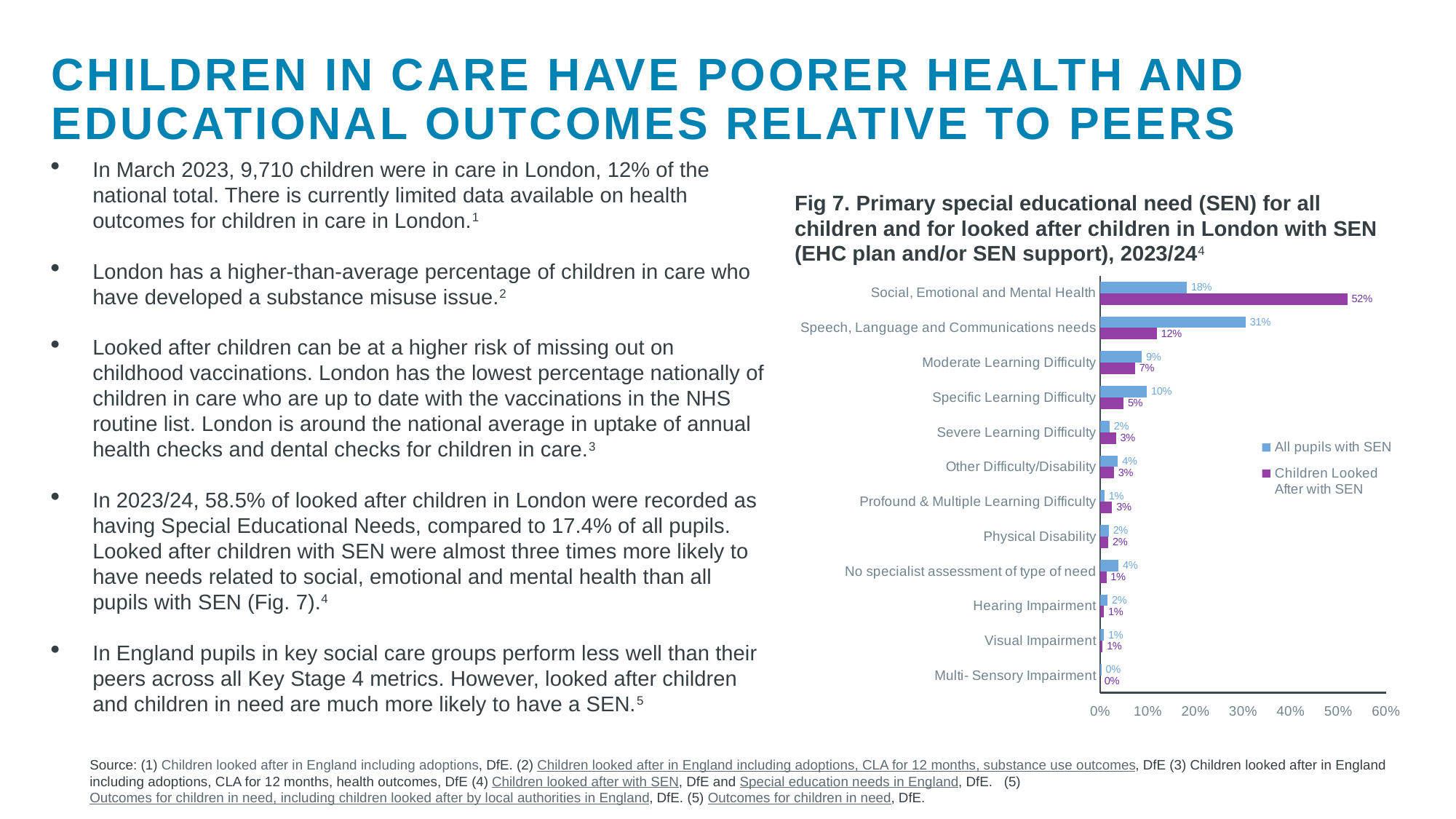
In Fig 7, what is the value for All pupils with SEN for Moderate Learning Difficulty? 9% In Fig 7, which category has the highest value for All pupils with SEN? Speech, Language and Communications needs In Fig 7, what is the value for Children Looked After with SEN for Social, Emotional and Mental Health? 52% In Fig 7, what is the value for All pupils with SEN for Speech, Language and Communications needs? 31% In Fig 7, what is the difference between the Children Looked After with SEN value and the All pupils with SEN value for Social, Emotional and Mental Health? 34% What kind of chart is Fig 7? Bar chart How many categories are shown in Fig 7? 12 How many series does the legend in Fig 7 list? 2 In Fig 7, what is the value for Children Looked After with SEN for Specific Learning Difficulty? 5% In Fig 7, for Speech, Language and Communications needs, which series has the larger value: All pupils with SEN or Children Looked After with SEN? All pupils with SEN In Fig 7, is the value for Children Looked After with SEN for Social, Emotional and Mental Health greater or less than 50%? greater In Fig 7, which category has the highest value for Children Looked After with SEN? Social, Emotional and Mental Health